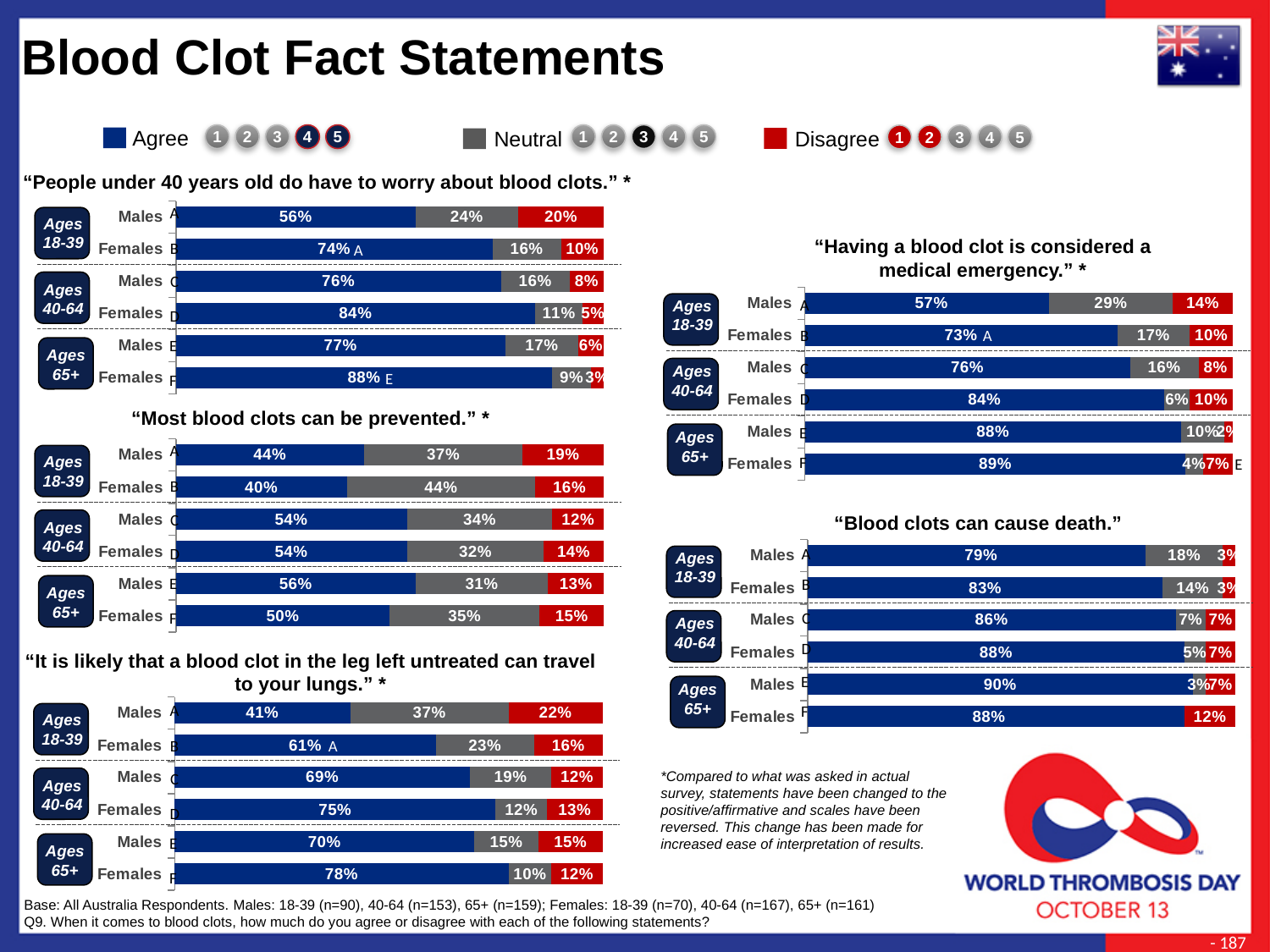
What type of chart is used for "Blood clots can cause death."? Stacked bar chart In the chart "People under 40 years old do have to worry about blood clots.", what percentage of Males aged 18-39 agree? 56% In the chart "Most blood clots can be prevented.", what percentage of Females aged 18-39 are neutral? 44% In the chart "It is likely that a blood clot in the leg left untreated can travel to your lungs.", what percentage of Males aged 18-39 disagree? 22% In the chart "Having a blood clot is considered a medical emergency.", what percentage of Males aged 18-39 are neutral? 29% In the chart "Having a blood clot is considered a medical emergency.", which group has the highest agree percentage? Females 65+ In the chart "People under 40 years old do have to worry about blood clots.", which group has the highest agree percentage? Females 65+ How many groups (bars) are shown in the chart "Most blood clots can be prevented."? 6 In the chart "Blood clots can cause death.", which is larger: the agree percentage for Males 18-39 or Females 18-39? Females 18-39 In the chart "It is likely that a blood clot in the leg left untreated can travel to your lungs.", what is the difference between the agree percentages of Females 65+ and Males 65+? 8% In the chart "Blood clots can cause death.", what percentage of Males aged 65+ agree? 90% In the chart "Most blood clots can be prevented.", which group has the lowest agree percentage? Females 18-39